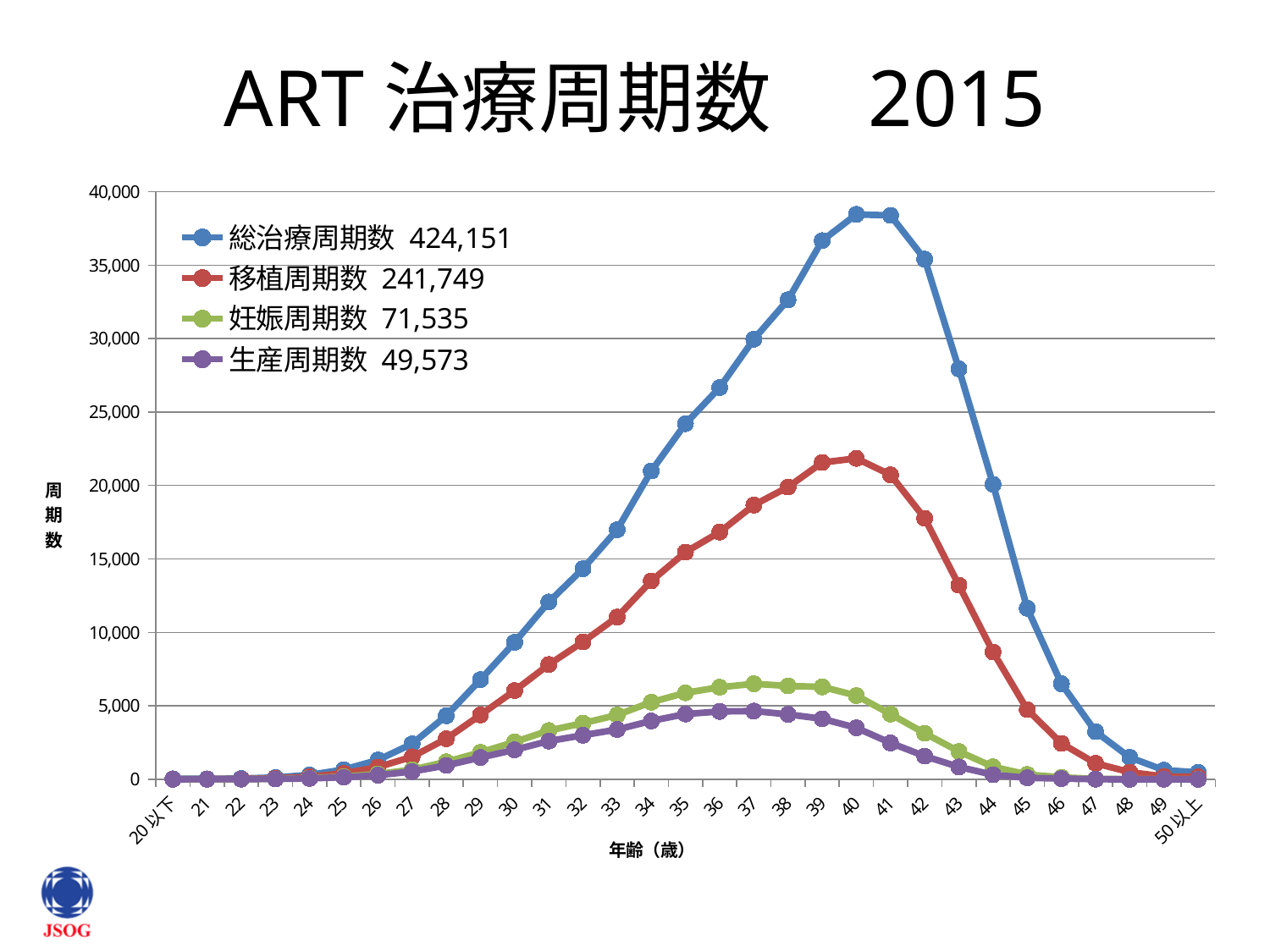
What total is printed in the legend for 妊娠周期数? 71,535 What total is printed in the legend for 生産周期数? 49,573 How many series does the legend list? 4 What total is printed in the legend for 総治療周期数? 424,151 What kind of chart is shown on the slide? line chart Is the value for 総治療周期数 at age 40 greater or less than 35,000? greater Which series has the highest values across the age range? 総治療周期数 Is the value for 移植周期数 at age 40 greater or less than 20,000? greater What total is printed in the legend for 移植周期数? 241,749 How many age categories are shown on the x axis? 31 Is the value for 生産周期数 at age 37 greater or less than 10,000? less Does 総治療周期数 rise or fall from age 41 to 50以上? fall